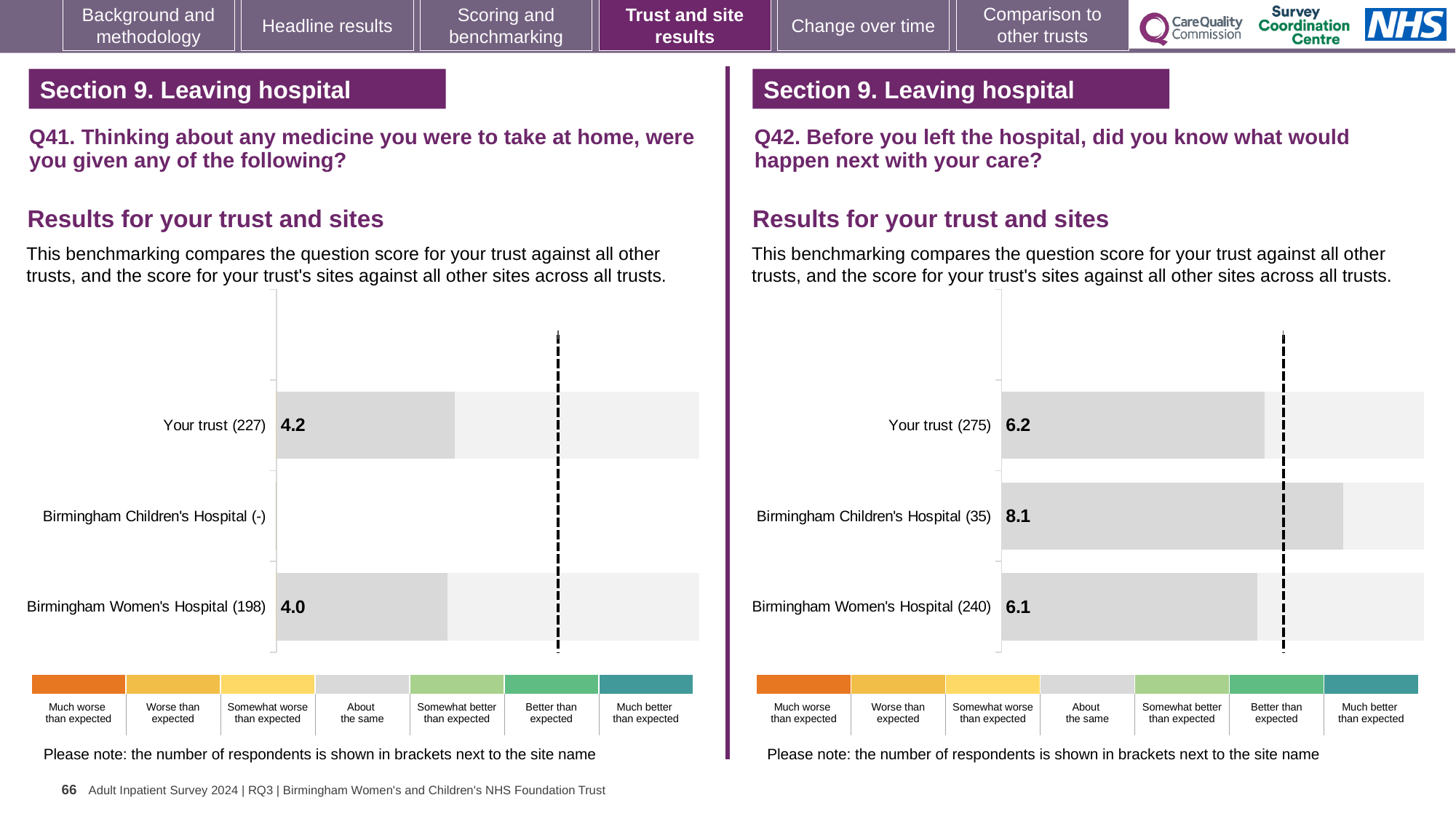
How many respondents are shown in brackets for Your trust in the Q42 chart on the right? 275 In the Q42 chart on the right, which row has the lowest score? Birmingham Women's Hospital What kind of chart is used on the left for Q41? Bar chart In the Q42 chart on the right, which site has the highest score? Birmingham Children's Hospital In the Q41 chart on the left, what is the difference between the scores for Your trust and Birmingham Women's Hospital? 0.2 In the Q41 chart on the left, what is the score for Birmingham Women's Hospital? 4.0 In the Q41 chart on the left, what is the score for Your trust? 4.2 In the Q42 chart on the right, what is the score for Birmingham Women's Hospital? 6.1 In the Q42 chart on the right, what is the score for Birmingham Children's Hospital? 8.1 In the Q42 chart on the right, which is larger: the score for Your trust or for Birmingham Children's Hospital? Birmingham Children's Hospital In the Q42 chart on the right, what is the difference between the scores for Birmingham Children's Hospital and Your trust? 1.9 In the Q41 chart on the left, how many respondents are shown in brackets for Birmingham Women's Hospital? 198